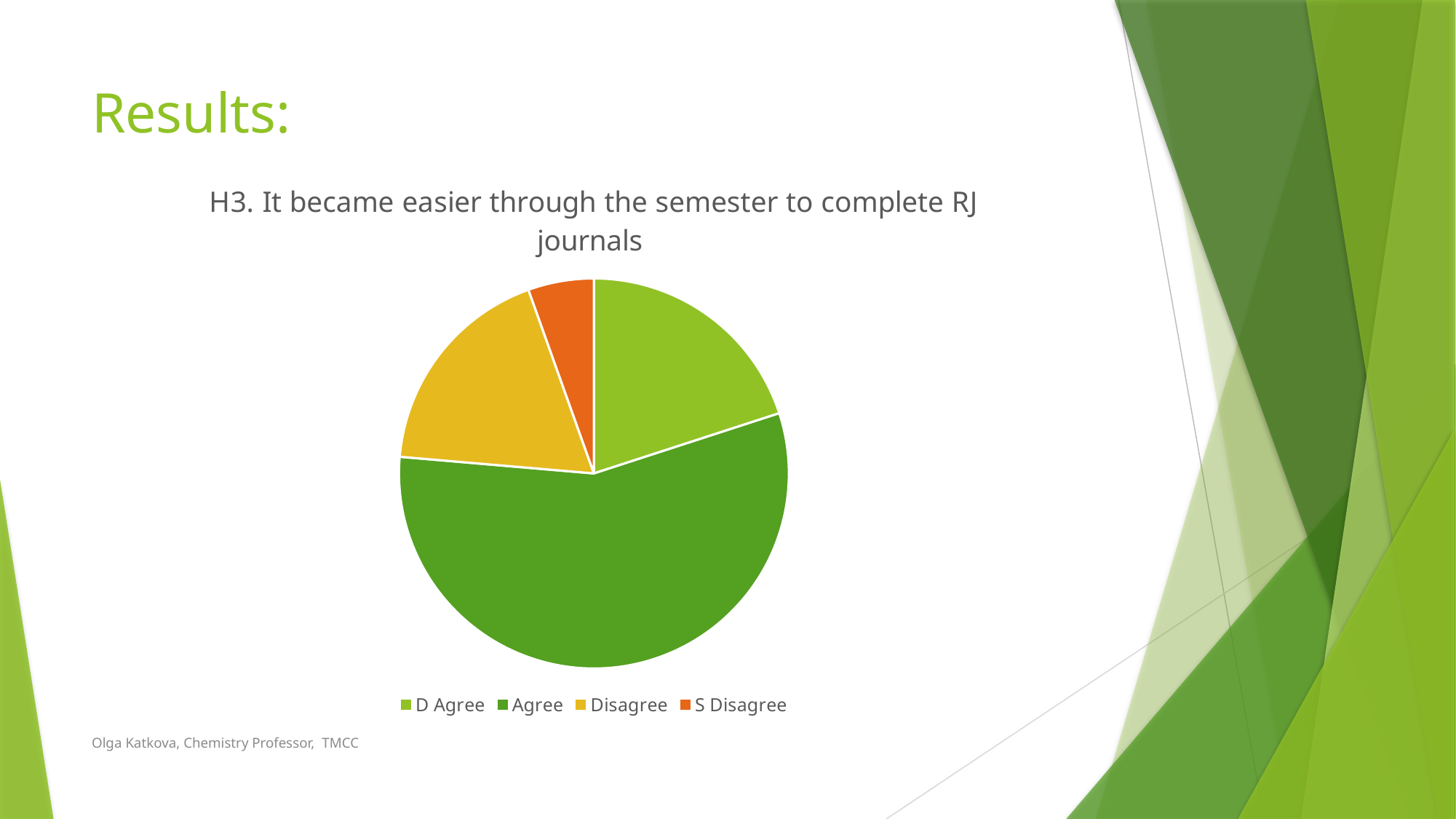
Which slice is larger, Agree or D Agree? Agree How many categories does the pie chart show? 4 Which category has the largest slice of the pie? Agree What is the title of the pie chart? H3. It became easier through the semester to complete RJ journals What kind of chart is shown on the slide? pie chart What colour is the S Disagree slice in the legend? orange Which slice is larger, D Agree or S Disagree? D Agree Does the Agree slice make up more or less than half of the pie? more Which category has the smallest slice of the pie? S Disagree